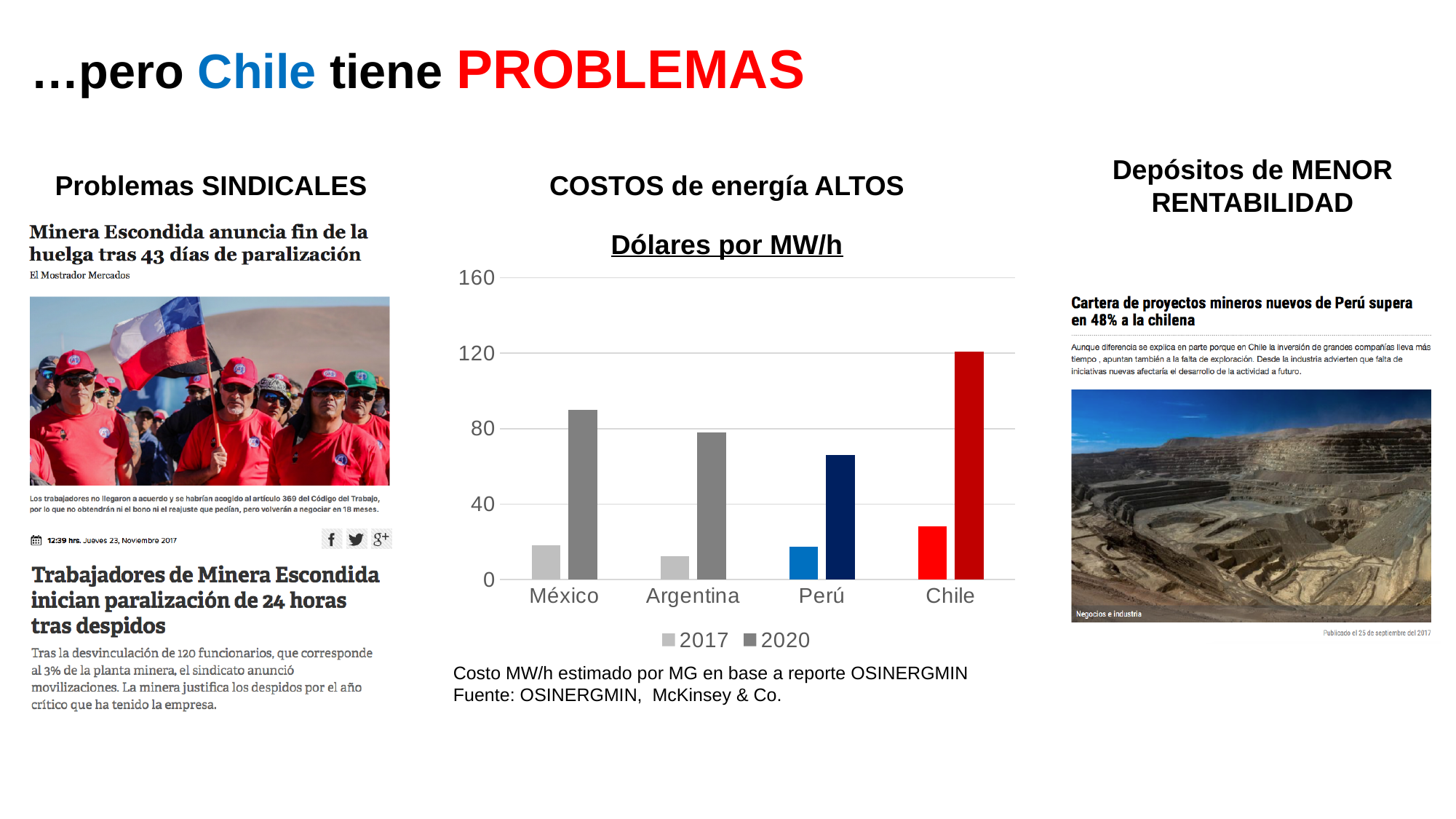
What is the title of the chart in the middle of the slide? Dólares por MW/h In the "Dólares por MW/h" chart, is the 2017 value for Chile greater or less than 40? less In the "Dólares por MW/h" chart, which country has the highest 2017 value? Chile In the "Dólares por MW/h" chart, is the 2020 value for Chile greater or less than 80? greater Which years are listed in the legend of the "Dólares por MW/h" chart? 2017 and 2020 In the "Dólares por MW/h" chart, is the 2020 value for Perú greater or less than 80? less How many countries are shown on the x axis of the "Dólares por MW/h" chart? 4 How many series does the legend of the "Dólares por MW/h" chart list? 2 In the "Dólares por MW/h" chart, which is larger: the 2020 value for México or the 2020 value for Argentina? México What kind of chart is shown under "COSTOS de energía ALTOS"? bar chart In the "Dólares por MW/h" chart, which country has the lowest 2017 value? Argentina In the "Dólares por MW/h" chart, which country has the highest 2020 value? Chile